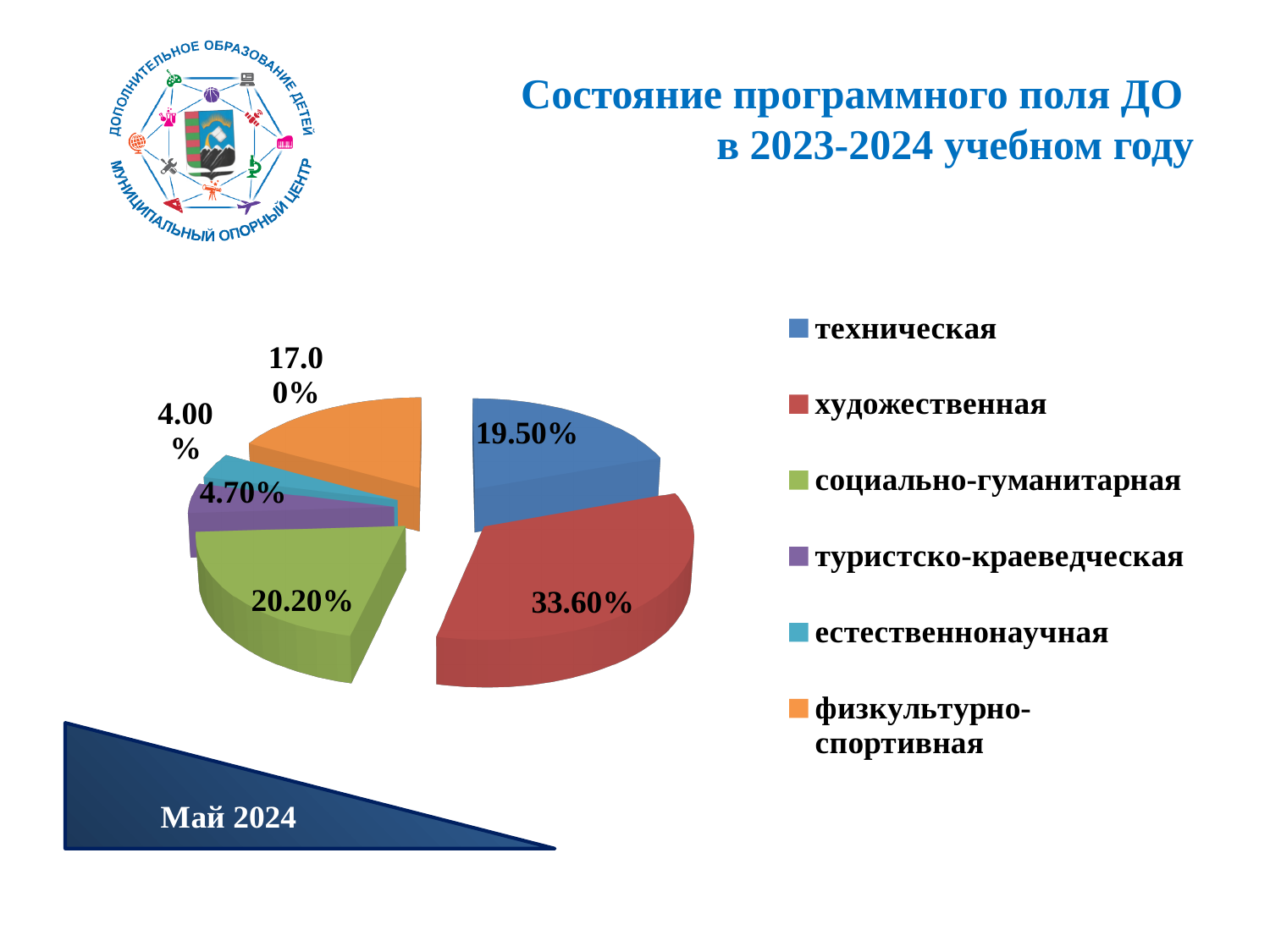
What is the difference between the художественная and техническая shares? 14.10% How many categories does the pie chart show? 6 Which category has the largest slice of the pie? художественная Which category has the smallest slice of the pie? естественнонаучная What is the value for the физкультурно-спортивная slice? 17.00% Which colour represents the художественная category in the legend? red What is the combined share of туристско-краеведческая and естественнонаучная? 8.70% Which is larger, the share for социально-гуманитарная or for физкультурно-спортивная? социально-гуманитарная What percentage is shown for социально-гуманитарная? 20.20% What kind of chart is shown on the slide? pie chart What share of the pie does the художественная category have? 33.60% What is the value shown for the техническая slice? 19.50%